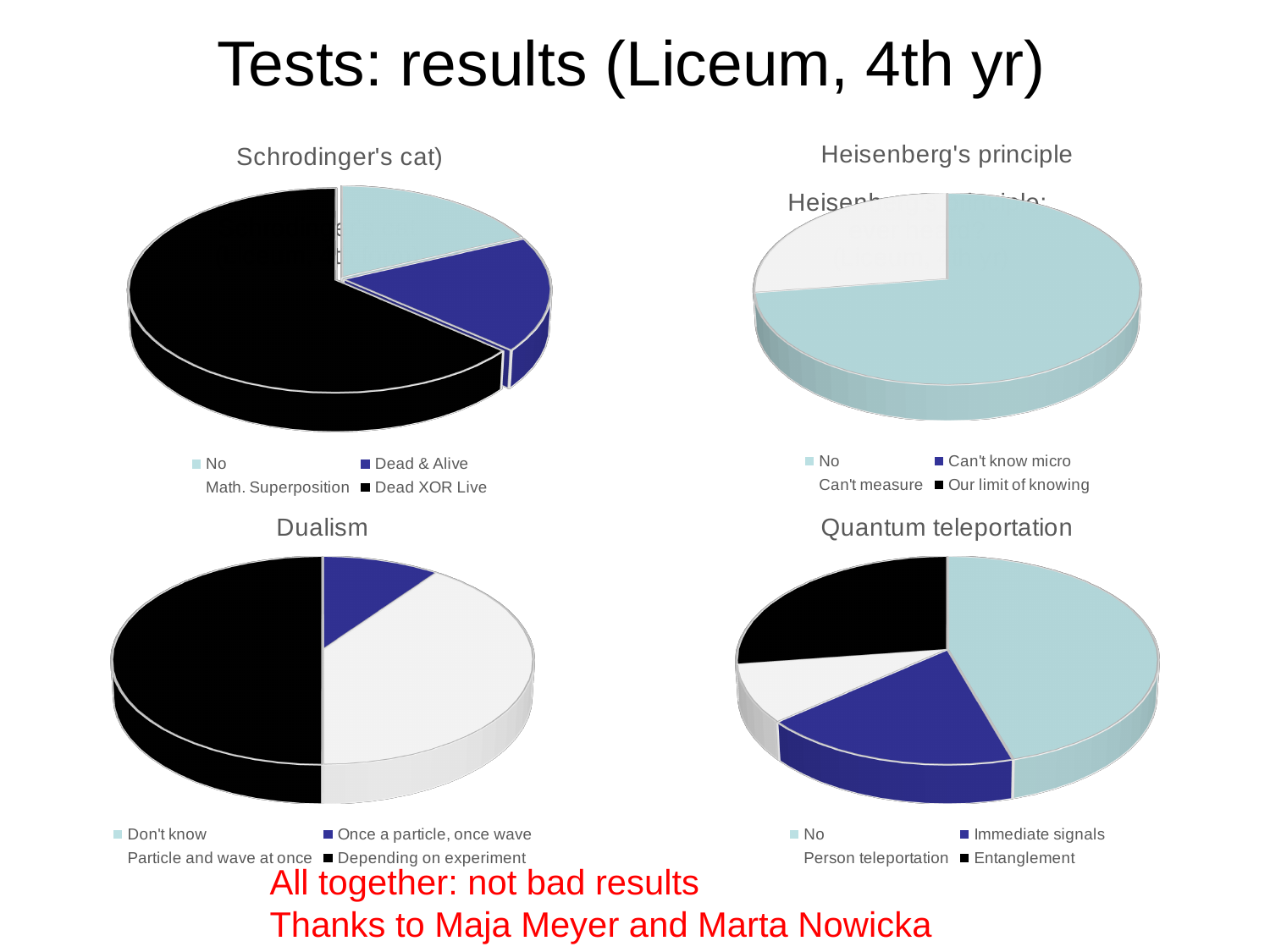
In the Dualism chart, which category has the largest slice? Depending on experiment In the Quantum teleportation chart, which category has the smallest slice? Person teleportation How many pie charts are shown on the slide? 4 In the Quantum teleportation chart, which slice is larger: Immediate signals or Person teleportation? Immediate signals How many categories does the legend of the Quantum teleportation chart list? 4 In the Dualism chart, which slice is larger: Depending on experiment or Once a particle, once wave? Depending on experiment In the Schrodinger's cat chart, which category has the largest slice? Dead XOR Live In the Quantum teleportation chart, what colour represents the category Entanglement? black What kind of chart is the Dualism chart? pie chart In the Heisenberg's principle chart, which category has the largest slice? No